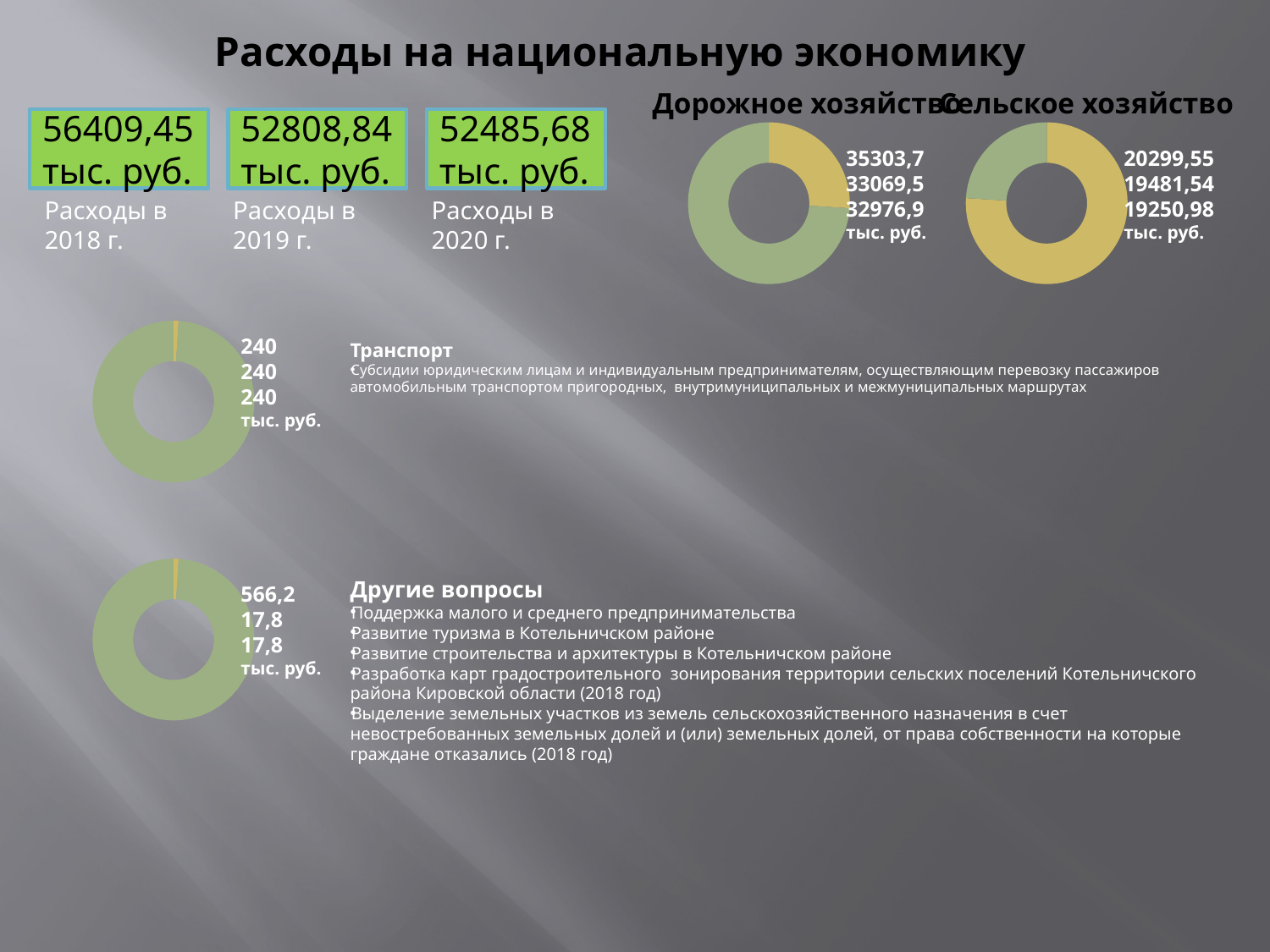
In the "Сельское хозяйство" chart, what is the smallest value listed? 19250,98 тыс. руб. In the "Дорожное хозяйство" chart, what is the smallest value listed? 32976,9 тыс. руб. In the "Другие вопросы" chart, what is the largest value listed? 566,2 тыс. руб. In the "Дорожное хозяйство" chart, what is the largest value listed? 35303,7 тыс. руб. In the "Другие вопросы" chart, what is the difference between the largest value (566,2) and the smallest value (17,8)? 548,4 тыс. руб. In the "Дорожное хозяйство" chart, what is the difference between the largest value (35303,7) and the second value (33069,5)? 2234,2 тыс. руб. Which is larger: the largest value in the "Дорожное хозяйство" chart or the largest value in the "Сельское хозяйство" chart? Дорожное хозяйство (35303,7) What is the total of the three values listed for the "Транспорт" chart? 720 тыс. руб. What kind of chart is used for "Дорожное хозяйство"? doughnut (pie) chart In the "Сельское хозяйство" chart, what is the largest value listed? 20299,55 тыс. руб. How many segments does the "Сельское хозяйство" doughnut chart have? 2